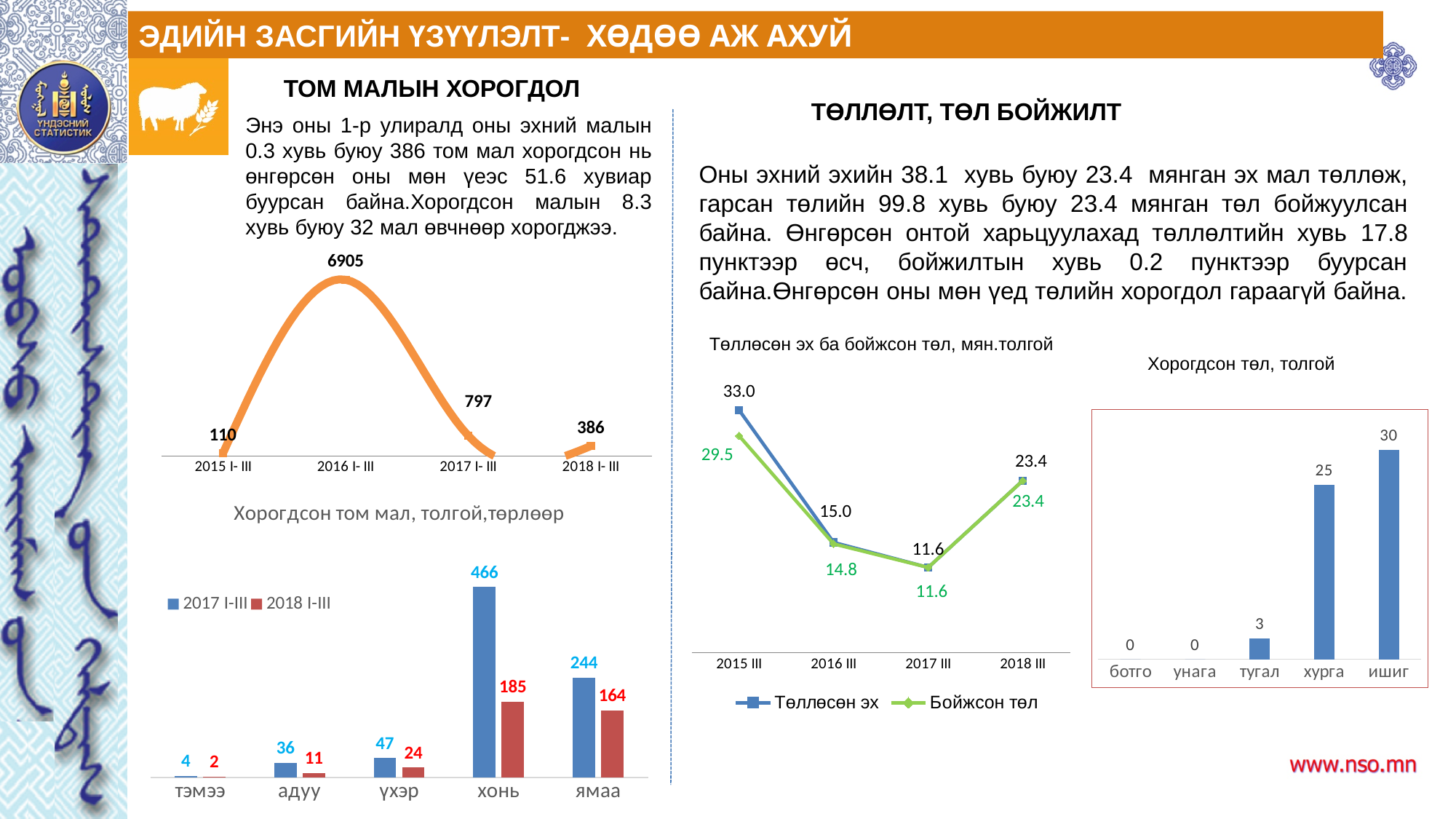
In the chart 'Хорогдсон том мал, толгой,төрлөөр', what is the 2018 I-III value for хонь? 185 In the chart 'Хорогдсон том мал, толгой,төрлөөр', how many series does the legend list? 2 In the top-left line chart of large livestock losses, what is the difference between the 2017 I-III and 2018 I-III values? 411 In the chart 'Хорогдсон төл, толгой', what is the value for хурга? 25 In the top-left line chart of large livestock losses, what is the value for 2016 I-III? 6905 In the chart 'Төллөсөн эх ба бойжсон төл, мян.толгой', what is the value of Бойжсон төл for 2015 III? 29.5 In the chart 'Төллөсөн эх ба бойжсон төл, мян.толгой', how many periods are shown on the x axis? 4 In the chart 'Хорогдсон том мал, толгой,төрлөөр', what is the difference between the 2017 I-III and 2018 I-III values for ямаа? 80 In the chart 'Хорогдсон том мал, толгой,төрлөөр', which category has the highest 2017 I-III value? хонь In the chart 'Төллөсөн эх ба бойжсон төл, мян.толгой', which is larger for 2016 III: Төллөсөн эх or Бойжсон төл? Төллөсөн эх What kind of chart is 'Хорогдсон төл, толгой'? bar chart In the top-left line chart of large livestock losses, which period has the lowest value? 2015 I- III